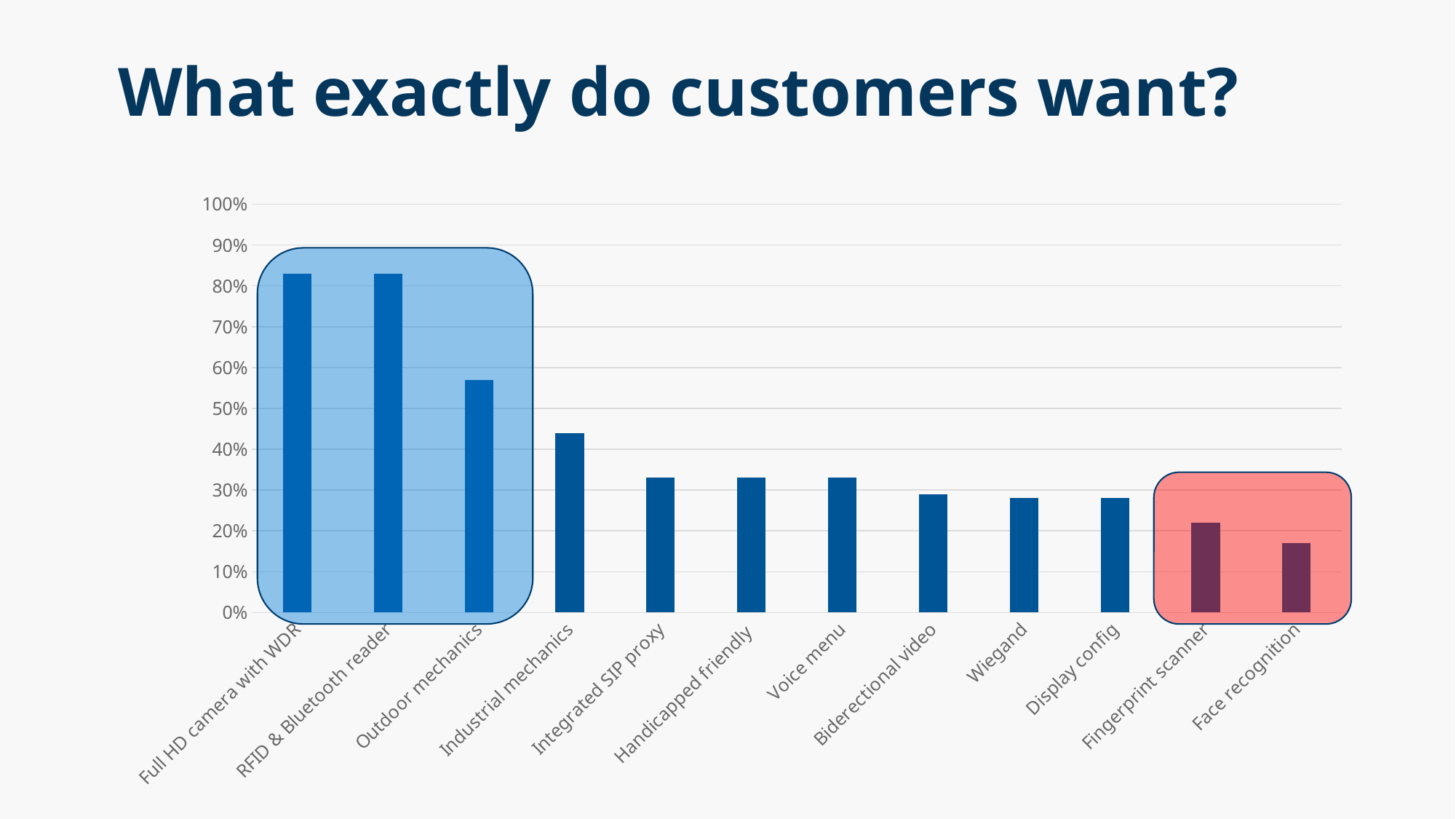
Is the value for Wiegand greater or less than 20%? greater Is the value for Outdoor mechanics greater or less than 50%? greater Do the values generally rise or fall moving from left to right along the x axis? Fall Is the value for Full HD camera with WDR greater or less than 80%? greater How many categories are plotted on the chart? 12 What is the title of the slide? What exactly do customers want? Which is larger, the value for Fingerprint scanner or the value for Face recognition? Fingerprint scanner What kind of chart is shown on the slide? Bar chart Which category has the lowest value on the chart? Face recognition Which is larger, the value for Outdoor mechanics or the value for Industrial mechanics? Outdoor mechanics